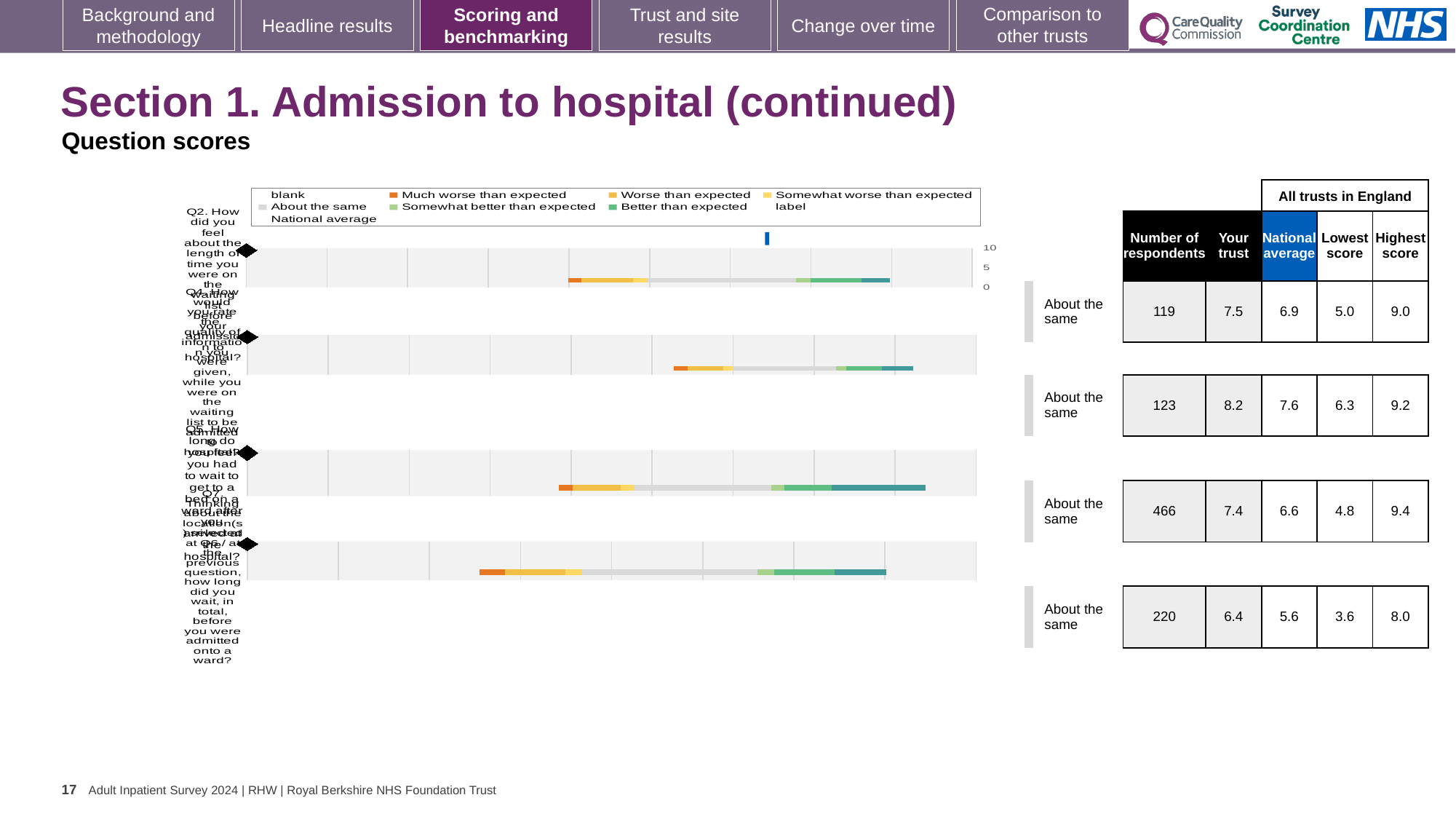
What is the highest score across all trusts in England for Q5? 9.4 Which question has the lowest 'Your trust' score? Q7 What is the lowest score across all trusts in England for Q7 (total wait before being admitted onto a ward)? 3.6 What is the 'Your trust' score for Q2 (length of time on the waiting list)? 7.5 How many question bars are plotted in the chart? 4 What kind of chart is shown on the slide? bar chart What benchmark category is shown for Q7? About the same Which question has the highest 'Your trust' score? Q4 How many respondents answered Q5 (how long you had to wait to get to a bed on a ward)? 466 What is the difference between the 'Your trust' score and the national average for Q5? 0.8 What is the national average score for Q4 (quality of information given while on the waiting list)? 7.6 Is the 'Your trust' score for Q2 larger or the national average for Q2? Your trust